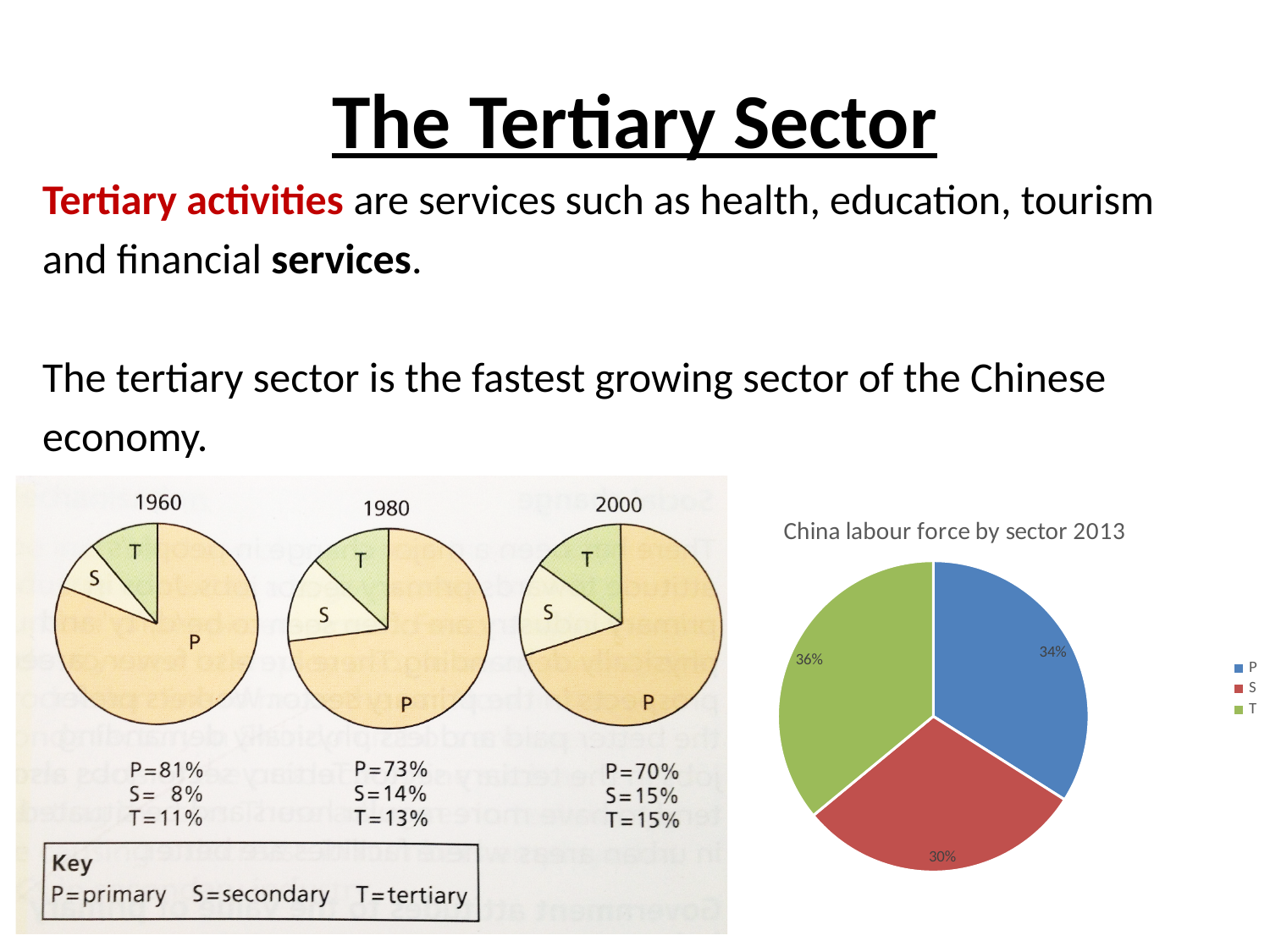
How many entries does the legend of the 'China labour force by sector 2013' chart list? 3 In the 1980 pie chart, what is the value for S? 14% In the 'China labour force by sector 2013' pie chart, which sector has the smallest share? S In the 'China labour force by sector 2013' pie chart, which sector has the largest share? T What type of chart is 'China labour force by sector 2013'? Pie chart In the 2000 pie chart, which of S or T is larger, or are they equal? Equal Across the 1960, 1980 and 2000 pie charts, does the value for P rise or fall over time? Fall In the 'China labour force by sector 2013' pie chart, what share does P have? 34% In the 'China labour force by sector 2013' pie chart, what is the difference between the shares of T and S? 6% In the 1960 pie chart on the left of the slide, what is the value for P? 81% In the 'China labour force by sector 2013' pie chart, what share does S have? 30% In the 'China labour force by sector 2013' pie chart, what colour is the slice for T? Green